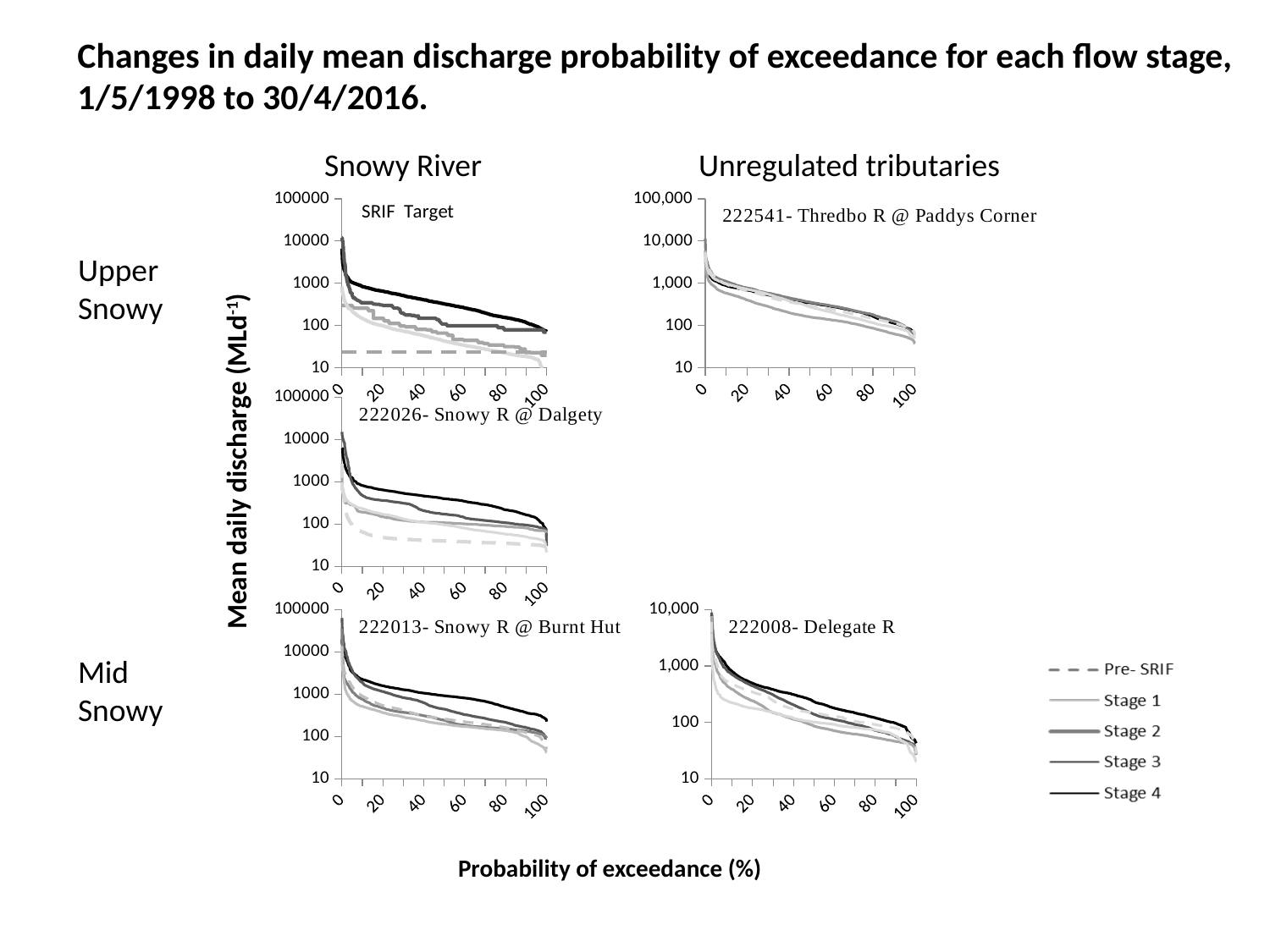
In the 'SRIF Target' chart, do the values rise or fall as probability of exceedance increases from 0 to 100? fall How many charts are shown on the slide? 5 In the 'SRIF Target' chart, is the Pre-SRIF value at 50% probability of exceedance greater or less than 100? less In the '222026- Snowy R @ Dalgety' chart, which series has the highest values across most of the probability range? Stage 4 In the '222013- Snowy R @ Burnt Hut' chart, which is larger at 60% probability of exceedance, Stage 4 or Stage 1? Stage 4 What kind of chart is the '222541- Thredbo R @ Paddys Corner' chart? line chart What is the label of the shared x axis at the bottom of the slide? Probability of exceedance (%) How many series does the legend on the slide list? 5 Which series is drawn as a dashed line in the legend? Pre- SRIF In the '222008- Delegate R' chart, is the Stage 4 value at 50% probability of exceedance greater or less than 100? greater In the 'SRIF Target' chart, is the Stage 4 value at 50% probability of exceedance greater or less than 100? greater